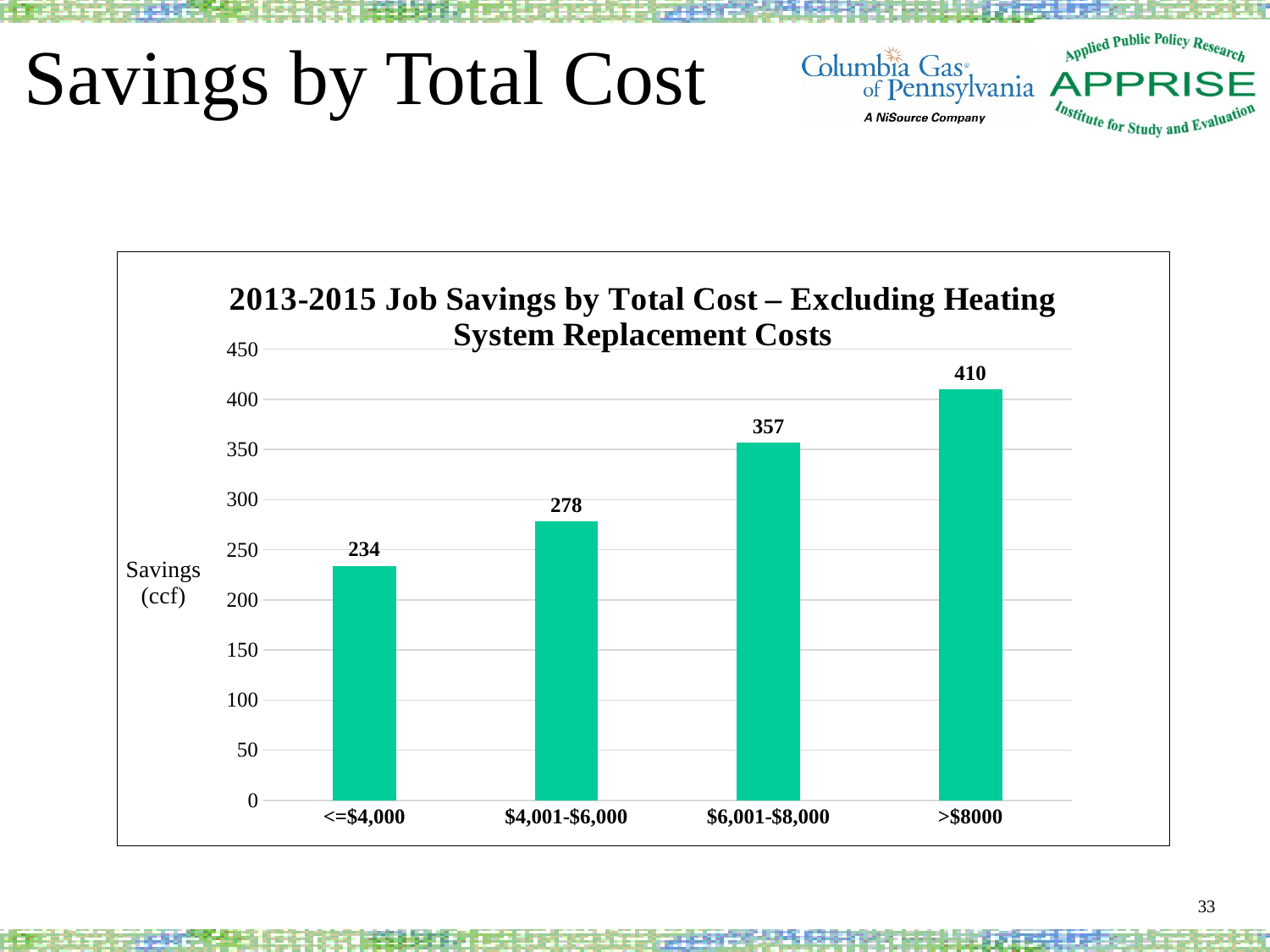
What is the savings value for the >$8000 cost category? 410 Do the savings values rise or fall as total cost increases along the x axis? Rise What is the difference in savings between the $6,001-$8,000 and $4,001-$6,000 categories? 79 Which has larger savings: $4,001-$6,000 or $6,001-$8,000? $6,001-$8,000 Which cost category has the lowest savings? <=$4,000 How many cost categories are shown in the chart? 4 Which cost category has the highest savings? >$8000 What is the difference in savings between the >$8000 and <=$4,000 categories? 176 What is the savings value for the <=$4,000 cost category? 234 What is the savings value for the $6,001-$8,000 cost category? 357 What is the savings value for the $4,001-$6,000 cost category? 278 What kind of chart is shown on the slide? Bar chart